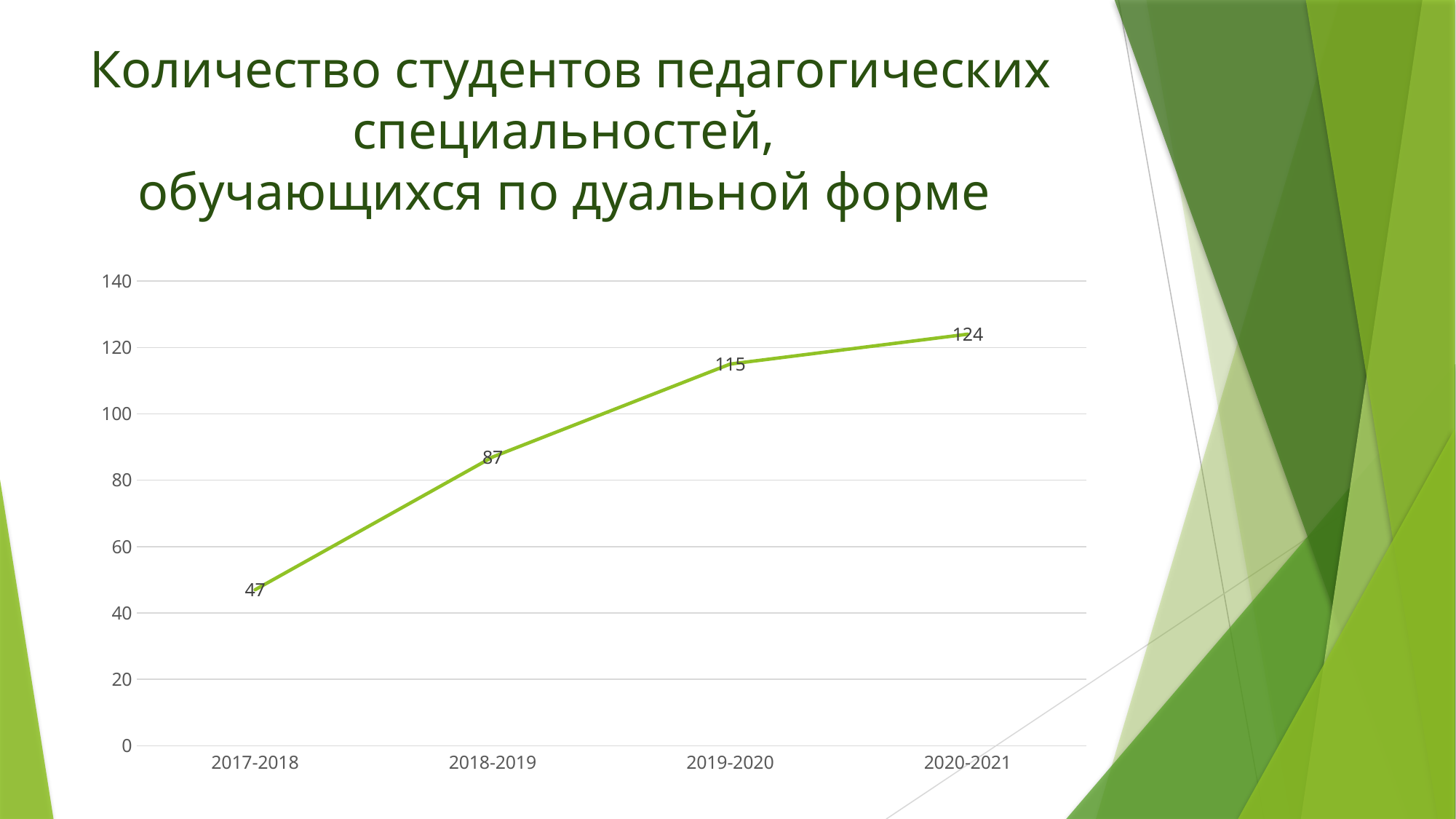
Is the value for 2019-2020 greater or less than 100? greater What is the value for 2019-2020? 115 Which is larger, the value for 2018-2019 or the value for 2019-2020? 2019-2020 What is the difference between the values for 2020-2021 and 2019-2020? 9 What is the value for 2017-2018? 47 What kind of chart is shown on the slide? line chart What is the difference between the values for 2018-2019 and 2017-2018? 40 What is the value for 2020-2021? 124 Which academic year has the lowest value? 2017-2018 What is the value for 2018-2019? 87 How many academic years are plotted on the chart? 4 Which academic year has the highest value? 2020-2021